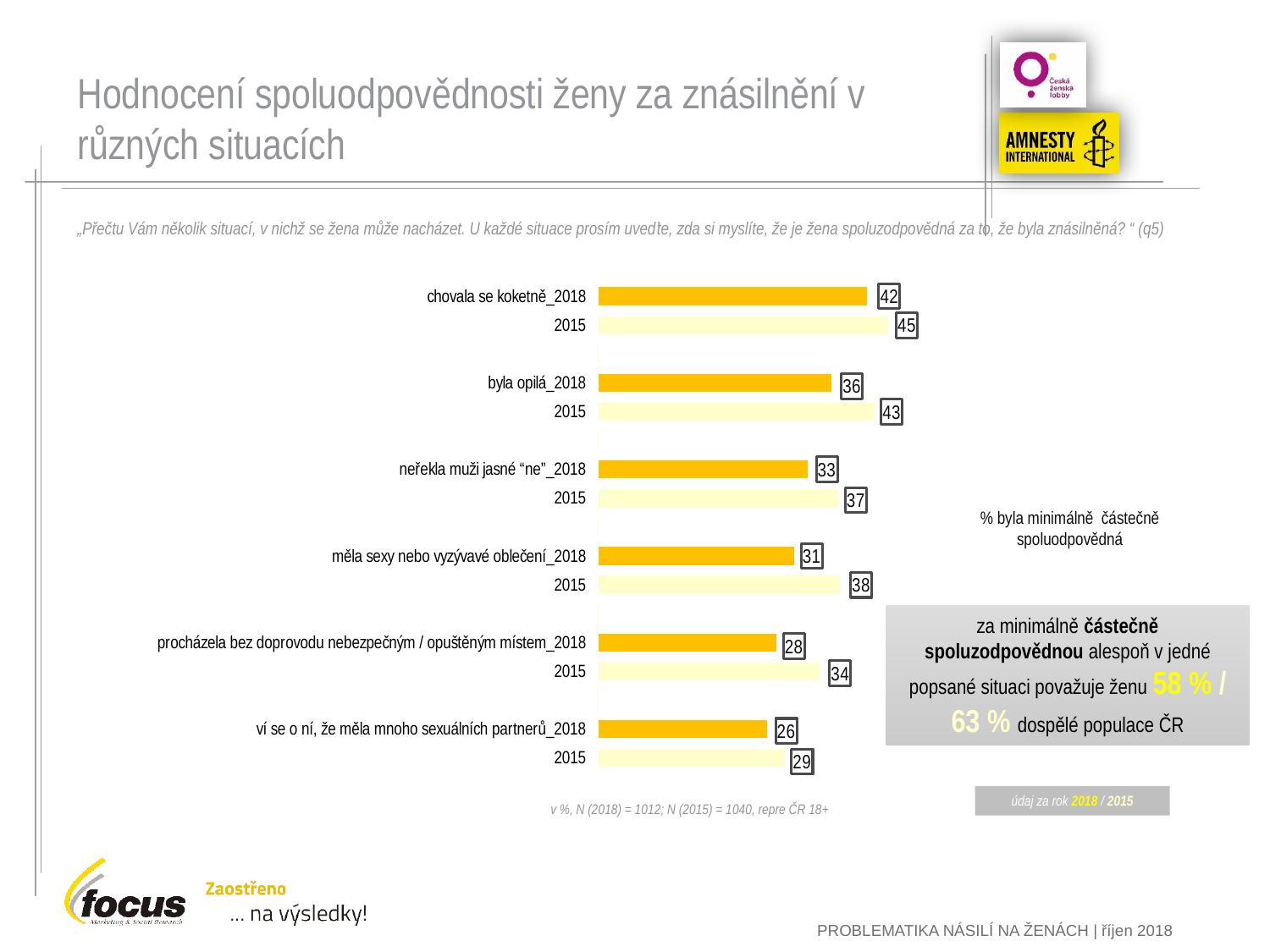
What value is shown for "byla opilá" in 2015? 43 Which situation has the highest value for 2018? chovala se koketně Which is larger for "neřekla muži jasné "ne"": the 2018 value or the 2015 value? 2015 What is the difference between the 2015 and 2018 values for "byla opilá"? 7 Which situation has the lowest value for 2015? ví se o ní, že měla mnoho sexuálních partnerů What value is shown for "ví se o ní, že měla mnoho sexuálních partnerů" in 2015? 29 How many situations (categories) are shown in the chart? 6 What is the difference between the 2015 and 2018 values for "měla sexy nebo vyzývavé oblečení"? 7 What kind of chart is shown on the slide? bar chart What value is shown for "měla sexy nebo vyzývavé oblečení" in 2018? 31 Which year do the darker (orange) bars represent? 2018 What value is shown for "chovala se koketně" in 2018? 42